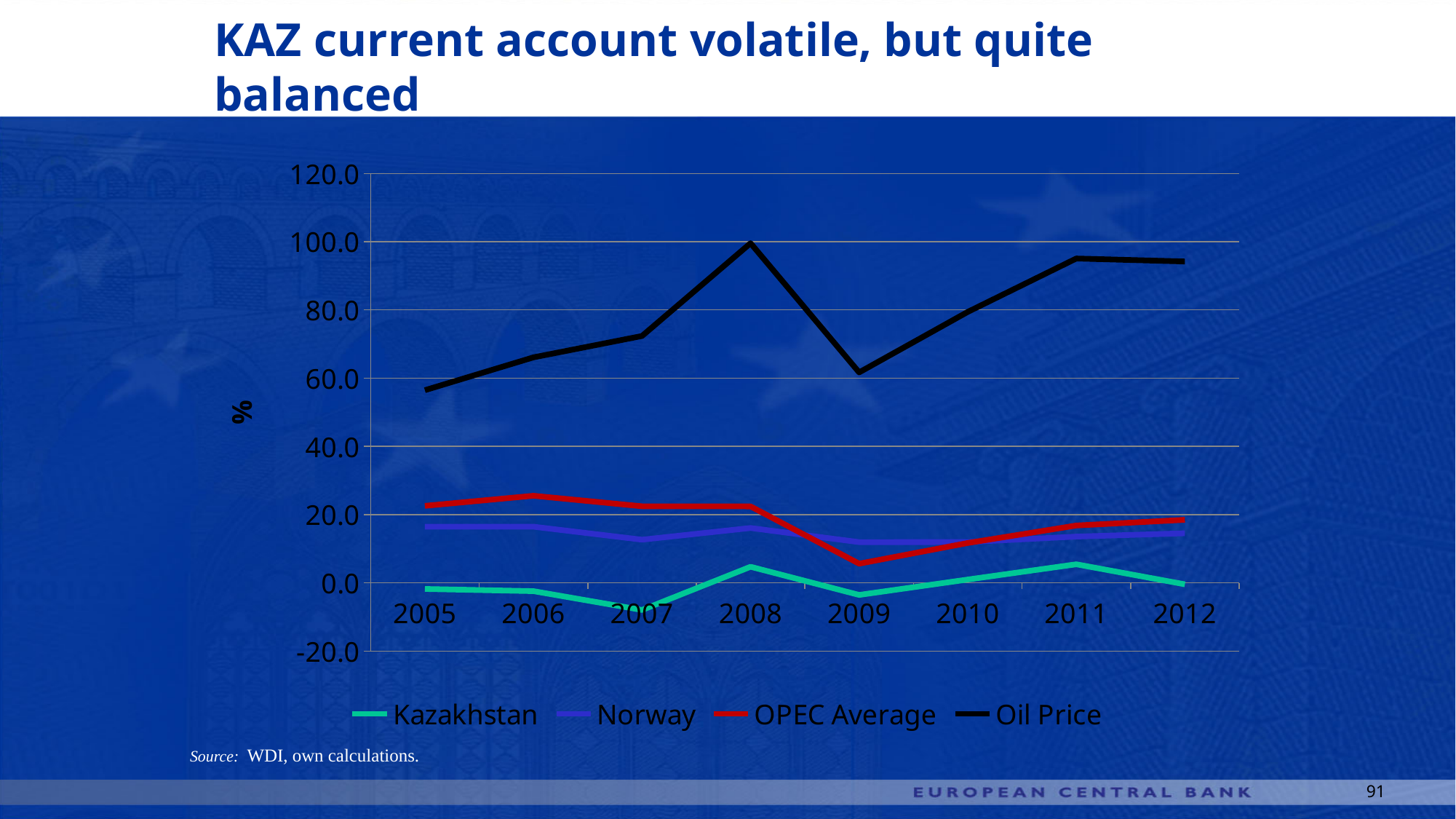
What label is shown on the y axis? % In which year is the Oil Price series at its lowest value? 2005 Is the value for Oil Price in 2011 greater or less than 80.0? greater How many series does the legend list? 4 In which year does the Oil Price series reach its highest value? 2008 How many years are shown on the x axis? 8 What kind of chart is shown on the slide? line chart Which series is higher in 2006, OPEC Average or Norway? OPEC Average Which series is higher in 2009, Norway or OPEC Average? Norway Is the value for Oil Price in 2009 greater or less than 80.0? less Does the Oil Price series rise or fall between 2009 and 2011? rise Is the value for OPEC Average in 2009 greater or less than 20.0? less